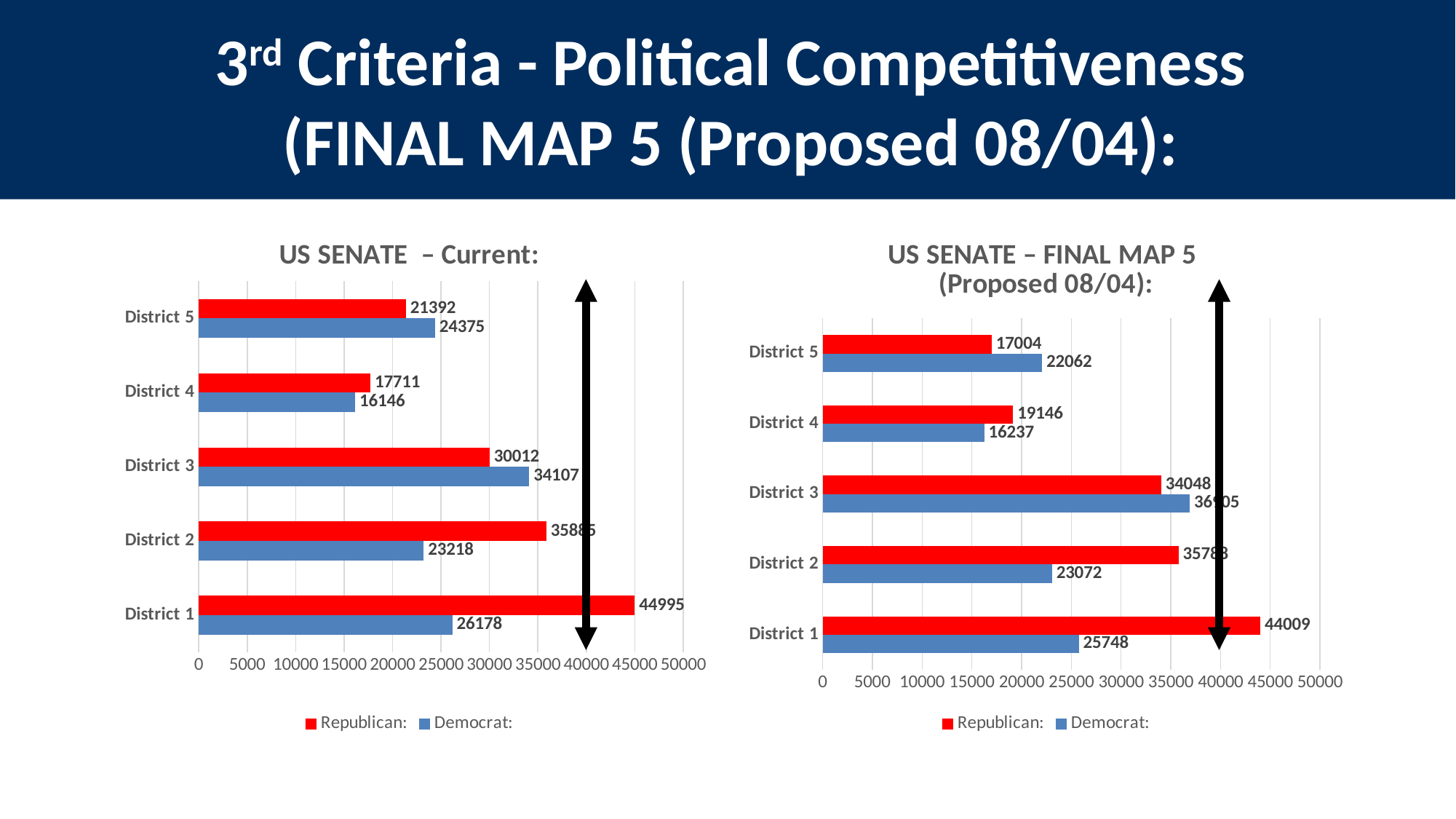
In the US SENATE – FINAL MAP 5 (Proposed 08/04) chart, what is the Democrat value for District 5? 22062 In the US SENATE – Current chart, what is the difference between the Republican and Democrat values for District 1? 18817 In the US SENATE – Current chart, what is the Republican value for District 1? 44995 How many districts are shown in the US SENATE – Current chart? 5 In the US SENATE – Current chart, which district has the lowest Democrat value? District 4 In the US SENATE – Current chart, is the Democrat value for District 1 greater or less than 30000? less In the US SENATE – FINAL MAP 5 (Proposed 08/04) chart, what is the Republican value for District 4? 19146 What type of chart is the US SENATE – FINAL MAP 5 (Proposed 08/04) chart? Bar chart In the US SENATE – FINAL MAP 5 (Proposed 08/04) chart, what is the difference between the Democrat and Republican values for District 5? 5058 In the US SENATE – FINAL MAP 5 (Proposed 08/04) chart, is the Republican or Democrat value larger for District 4? Republican In the US SENATE – Current chart, which district has the highest Republican value? District 1 In the US SENATE – Current chart, what is the Democrat value for District 3? 34107